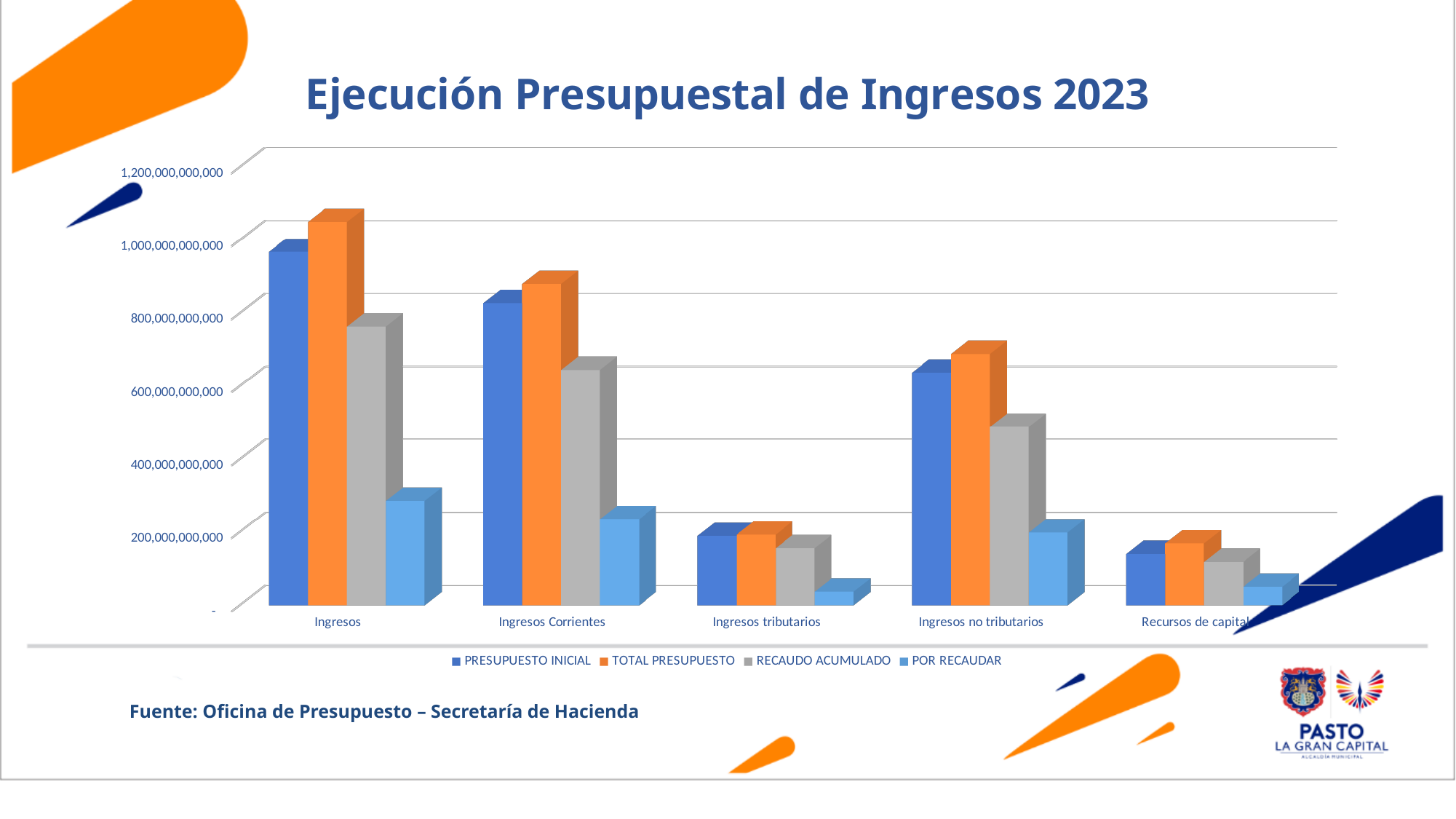
Which series is shown in orange in the chart? TOTAL PRESUPUESTO Which category has the highest TOTAL PRESUPUESTO value? Ingresos What is the title of the chart? Ejecución Presupuestal de Ingresos 2023 Is the PRESUPUESTO INICIAL value for Ingresos greater or less than 800,000,000,000? greater For RECAUDO ACUMULADO, which is larger: Ingresos Corrientes or Ingresos no tributarios? Ingresos Corrientes How many series does the chart legend list? 4 For the Ingresos category, which is larger: TOTAL PRESUPUESTO or RECAUDO ACUMULADO? TOTAL PRESUPUESTO How many categories are shown on the x axis of the chart? 5 Is the TOTAL PRESUPUESTO value for Ingresos tributarios greater or less than 400,000,000,000? less What kind of chart is shown on the slide? Bar chart Is the POR RECAUDAR value for Ingresos greater or less than 400,000,000,000? less Which category has the lowest PRESUPUESTO INICIAL value? Recursos de capital